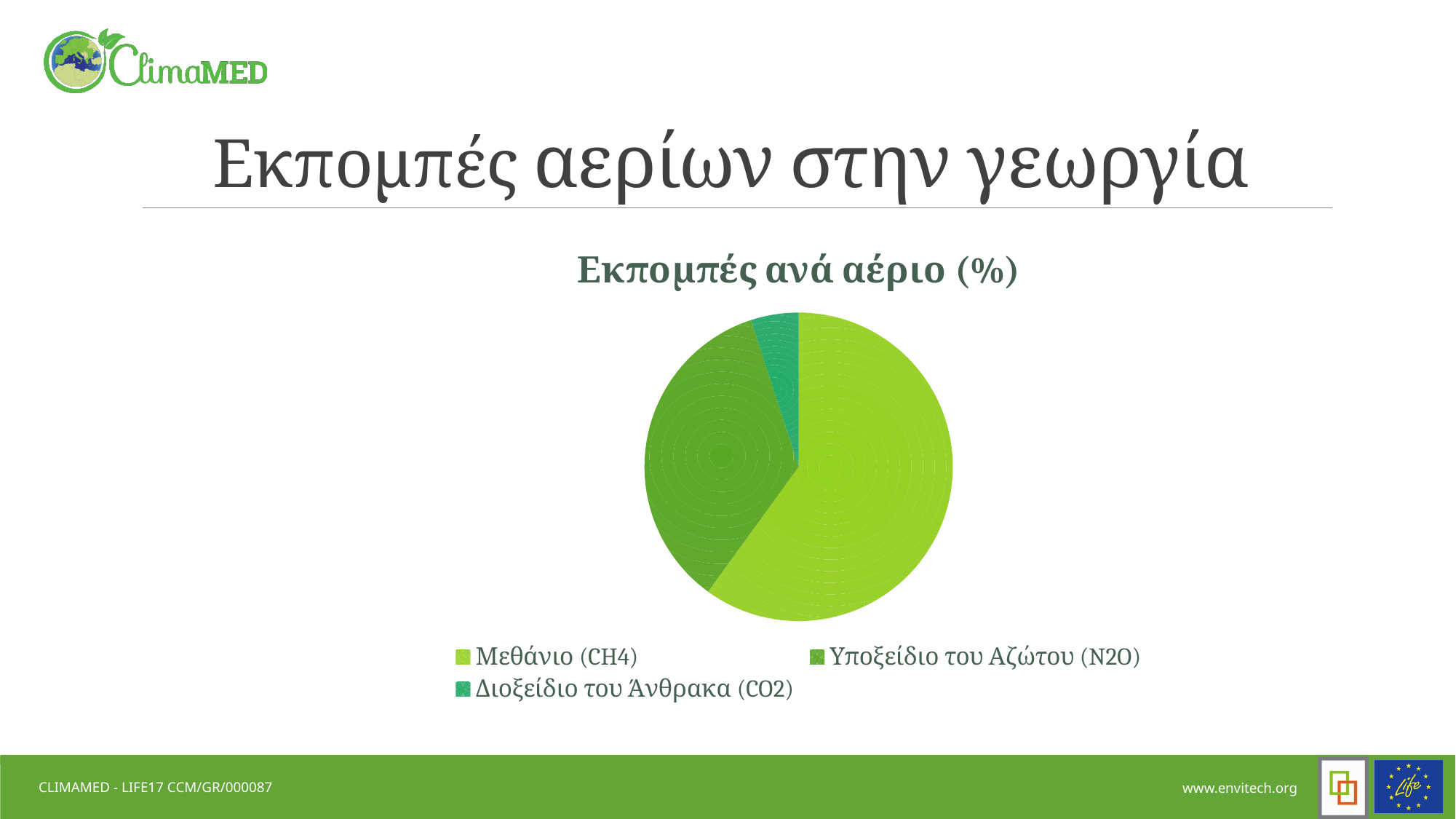
What kind of chart is shown on the slide? Pie chart What is the title of the chart? Εκπομπές ανά αέριο (%) How many entries does the legend list? 3 Which gas has the largest slice of the pie? Μεθάνιο (CH4) How many slices does the pie chart have? 3 Which gas has the smallest slice of the pie? Διοξείδιο του Άνθρακα (CO2) Which slice is larger: Υποξείδιο του Αζώτου (N2O) or Διοξείδιο του Άνθρακα (CO2)? Υποξείδιο του Αζώτου (N2O) Which legend entry is shown in the lightest green colour? Μεθάνιο (CH4) Which slice is larger: Μεθάνιο (CH4) or Υποξείδιο του Αζώτου (N2O)? Μεθάνιο (CH4)